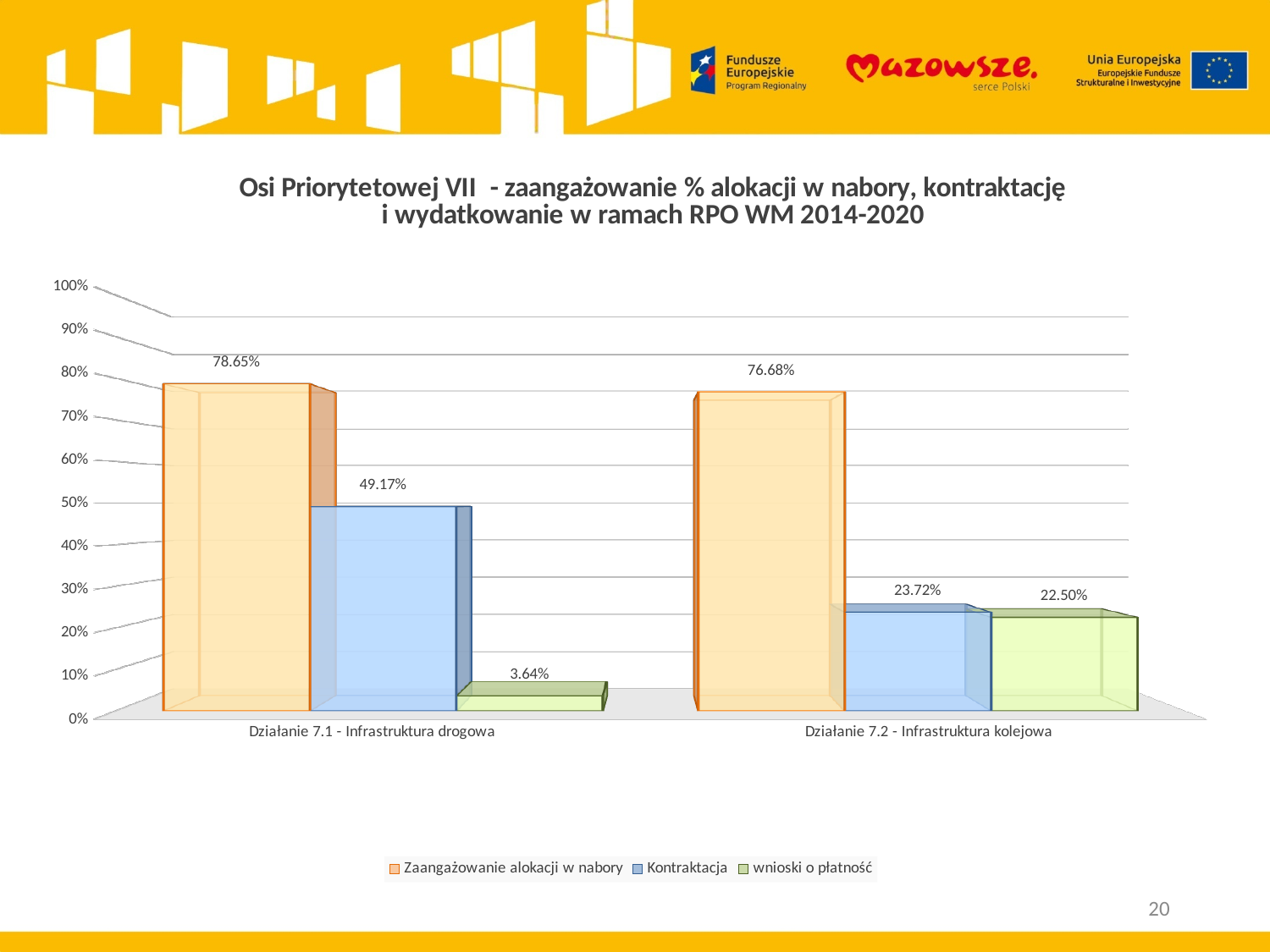
Which series has the lowest value for Działanie 7.1 - Infrastruktura drogowa? wnioski o płatność Which series is shown in blue in the legend? Kontraktacja What is the difference between Kontraktacja and wnioski o płatność for Działanie 7.2 - Infrastruktura kolejowa? 1.22% What is the value of Zaangażowanie alokacji w nabory for Działanie 7.1 - Infrastruktura drogowa? 78.65% What is the value of wnioski o płatność for Działanie 7.2 - Infrastruktura kolejowa? 22.50% What is the value of Kontraktacja for Działanie 7.2 - Infrastruktura kolejowa? 23.72% What is the difference between Zaangażowanie alokacji w nabory for Działanie 7.1 and for Działanie 7.2? 1.97% What is the value of wnioski o płatność for Działanie 7.1 - Infrastruktura drogowa? 3.64% How many series does the legend list? 3 What kind of chart is shown on the slide? Bar chart How many categories are shown on the x axis? 2 Which category has the higher Kontraktacja value? Działanie 7.1 - Infrastruktura drogowa